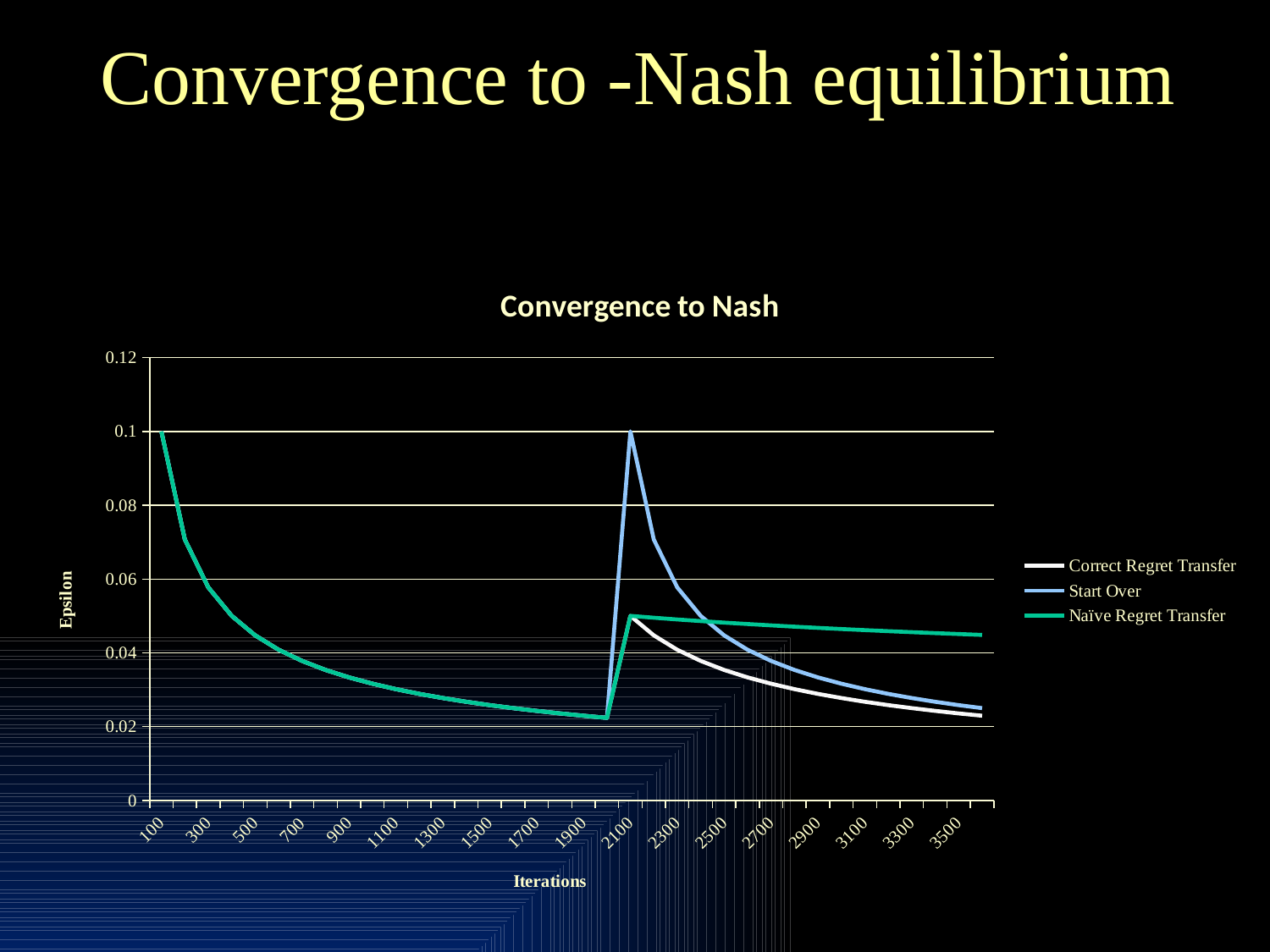
What is the label of the vertical axis? Epsilon What kind of chart is shown on the slide? line chart Is the value for Start Over at iteration 2100 greater or less than 0.08? greater Between iterations 100 and 1900, do the plotted values rise or fall? fall Is the value for Correct Regret Transfer at iteration 3500 greater or less than 0.04? less Is the value for Naïve Regret Transfer at iteration 1900 greater or less than 0.04? less How many series does the legend list? 3 At iteration 3500, which series has the higher value: Naïve Regret Transfer or Correct Regret Transfer? Naïve Regret Transfer What is the title of the chart? Convergence to Nash Which series has the highest value at iteration 2100? Start Over After its peak at iteration 2100, does the Start Over line rise or fall as iterations increase? fall